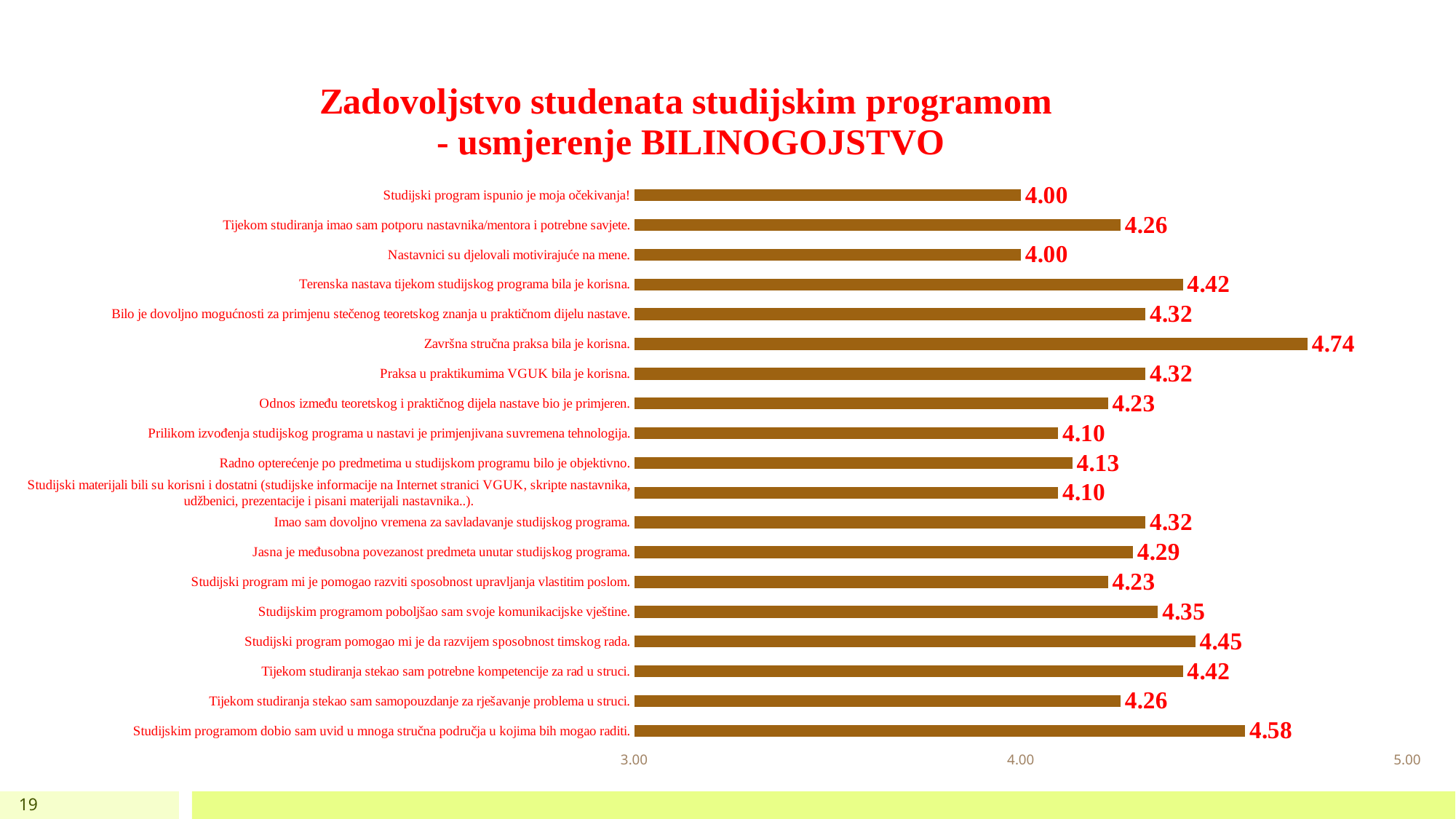
Which is larger: the value for "Terenska nastava tijekom studijskog programa bila je korisna." or the value for "Jasna je međusobna povezanost predmeta unutar studijskog programa."? Terenska nastava tijekom studijskog programa bila je korisna. What is the difference between the value for "Studijskim programom dobio sam uvid u mnoga stručna područja u kojima bih mogao raditi." and the value for "Studijski program pomogao mi je da razvijem sposobnost timskog rada."? 0.13 Is the value for "Studijskim programom poboljšao sam svoje komunikacijske vještine." greater or less than 4.00? greater How many statements (bars) are shown in the chart? 19 What is the value for "Studijskim programom dobio sam uvid u mnoga stručna područja u kojima bih mogao raditi."? 4.58 What is the value for "Završna stručna praksa bila je korisna."? 4.74 What is the difference between the value for "Završna stručna praksa bila je korisna." and the value for "Studijski program ispunio je moja očekivanja!"? 0.74 What is the value for "Studijski program pomogao mi je da razvijem sposobnost timskog rada."? 4.45 Which statement has the highest value? Završna stručna praksa bila je korisna. What is the title of the chart? Zadovoljstvo studenata studijskim programom - usmjerenje BILINOGOJSTVO What kind of chart is shown on the slide? bar chart What is the value for "Radno opterećenje po predmetima u studijskom programu bilo je objektivno."? 4.13